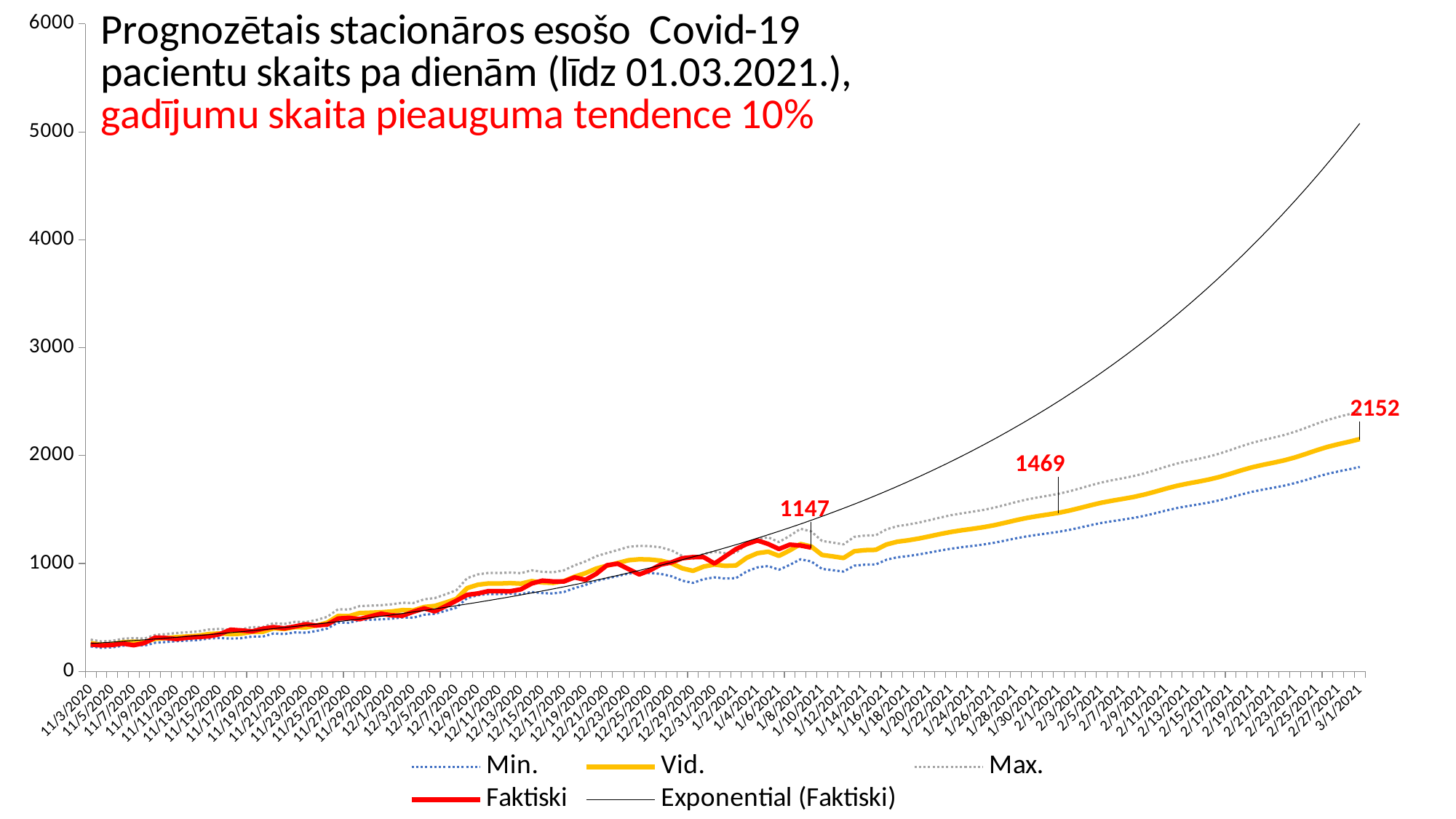
What kind of chart is shown on the slide? line chart Is the value of the Exponential (Faktiski) series at 3/1/2021 greater or less than 4000? greater Which series has the lowest value at 3/1/2021? Min. Is the value of the Min. series at 3/1/2021 greater or less than 2000? less Do the values of the Vid. series rise or fall from 11/3/2020 to 3/1/2021? rise Which series has the highest value at 3/1/2021? Exponential (Faktiski) What value is labelled on the chart at 1/10/2021? 1147 What is the labelled value for the Vid. series on 3/1/2021? 2152 What colour is the Faktiski line in the chart? red How many series does the legend list? 5 What is the difference between the labelled values 2152 (3/1/2021) and 1469 (2/1/2021)? 683 What is the labelled value for the Vid. series on 2/1/2021? 1469